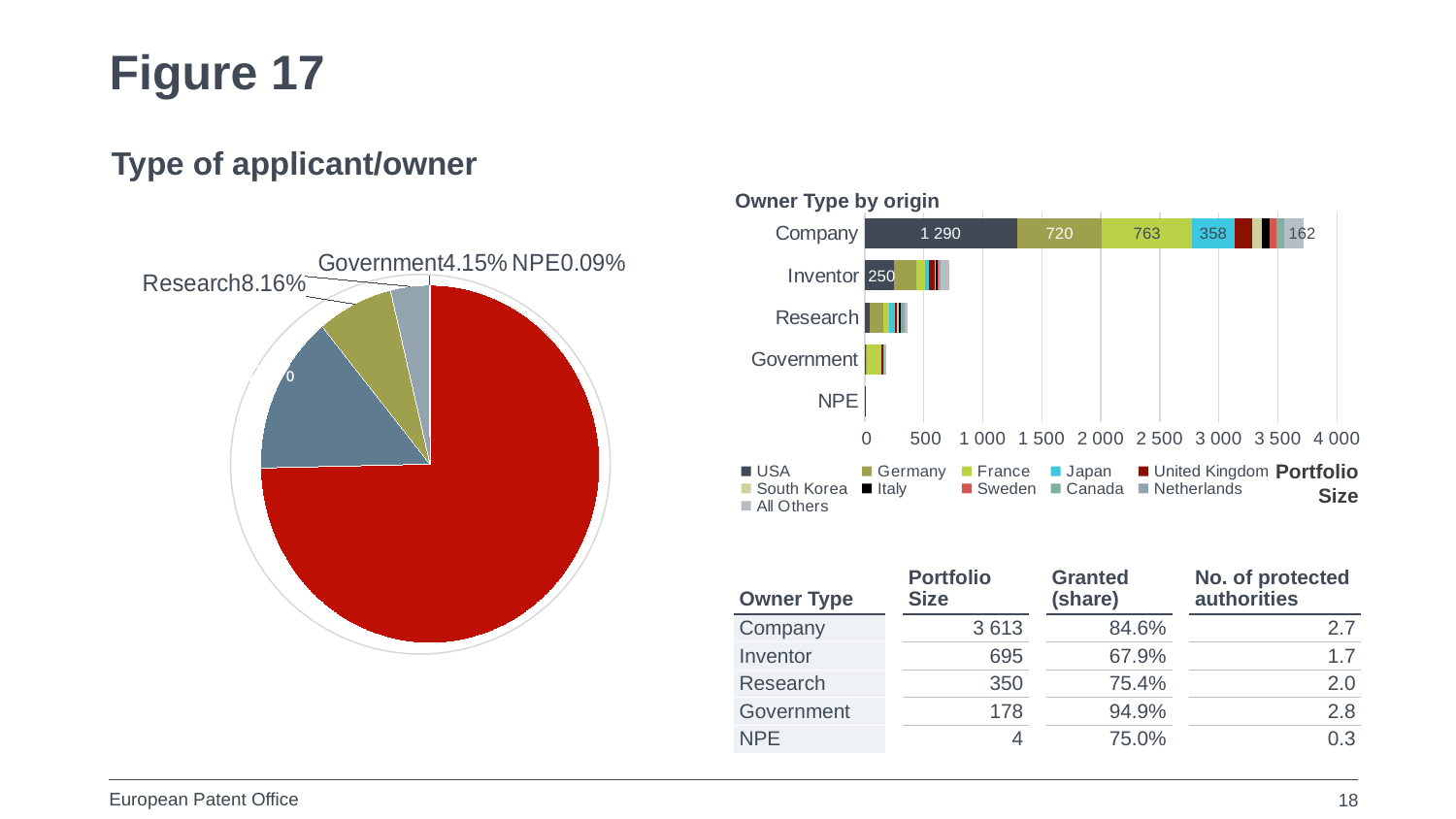
In the 'Owner Type by origin' chart, what is the USA value for Inventor? 250 What kind of chart is the chart on the left of the slide? pie chart In the 'Owner Type by origin' chart, how many owner type categories are shown on the vertical axis? 5 In the 'Owner Type by origin' chart, what is the USA value for Company? 1 290 In the 'Owner Type by origin' chart, what is the difference between the USA and France values for Company? 527 In the 'Owner Type by origin' chart, which owner type has the longest bar? Company In the pie chart on the left, what share is shown for Research? 8.16% In the pie chart on the left, what share is shown for NPE? 0.09% In the 'Owner Type by origin' chart, what is the Japan value for Company? 358 In the pie chart on the left, what share is shown for Government? 4.15% In the 'Owner Type by origin' chart, how many series does the legend list? 11 In the 'Owner Type by origin' chart, what is the France value for Company? 763